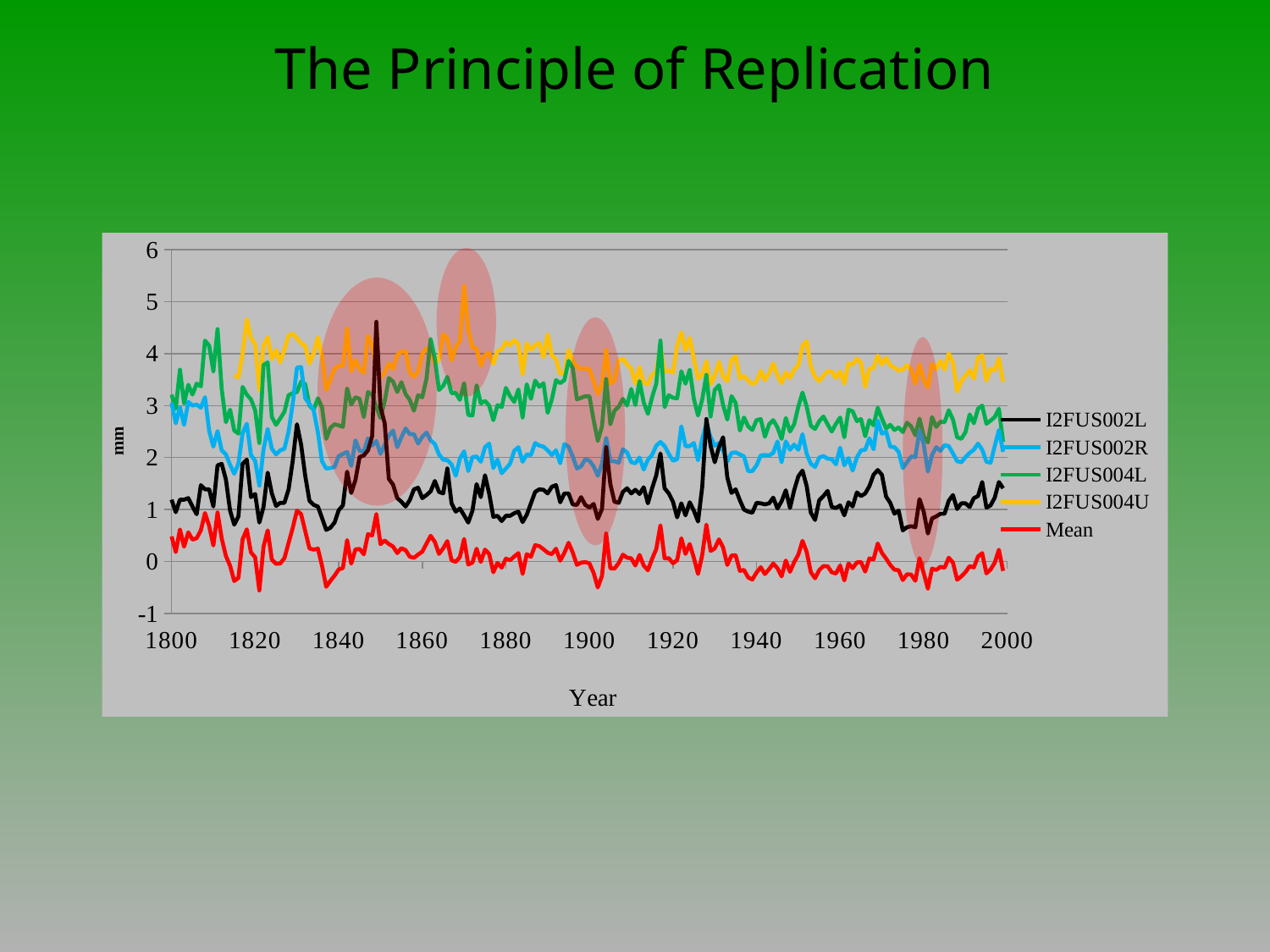
How many series does the legend list? 5 Is the value of I2FUS002R around 1940 greater or less than 3? less Around 1900, which series is higher, I2FUS004L or I2FUS002R? I2FUS004L Is the value of I2FUS004L around 1810 greater or less than 3? greater Which series is generally higher, I2FUS004U or Mean? I2FUS004U Is the peak of I2FUS002L near 1850 greater or less than 4? greater What is the label on the y axis? mm Which series has the lowest values overall across the chart? Mean Which series has the highest values overall across the chart? I2FUS004U What kind of chart is shown on the slide? line chart What colour is the Mean line? red